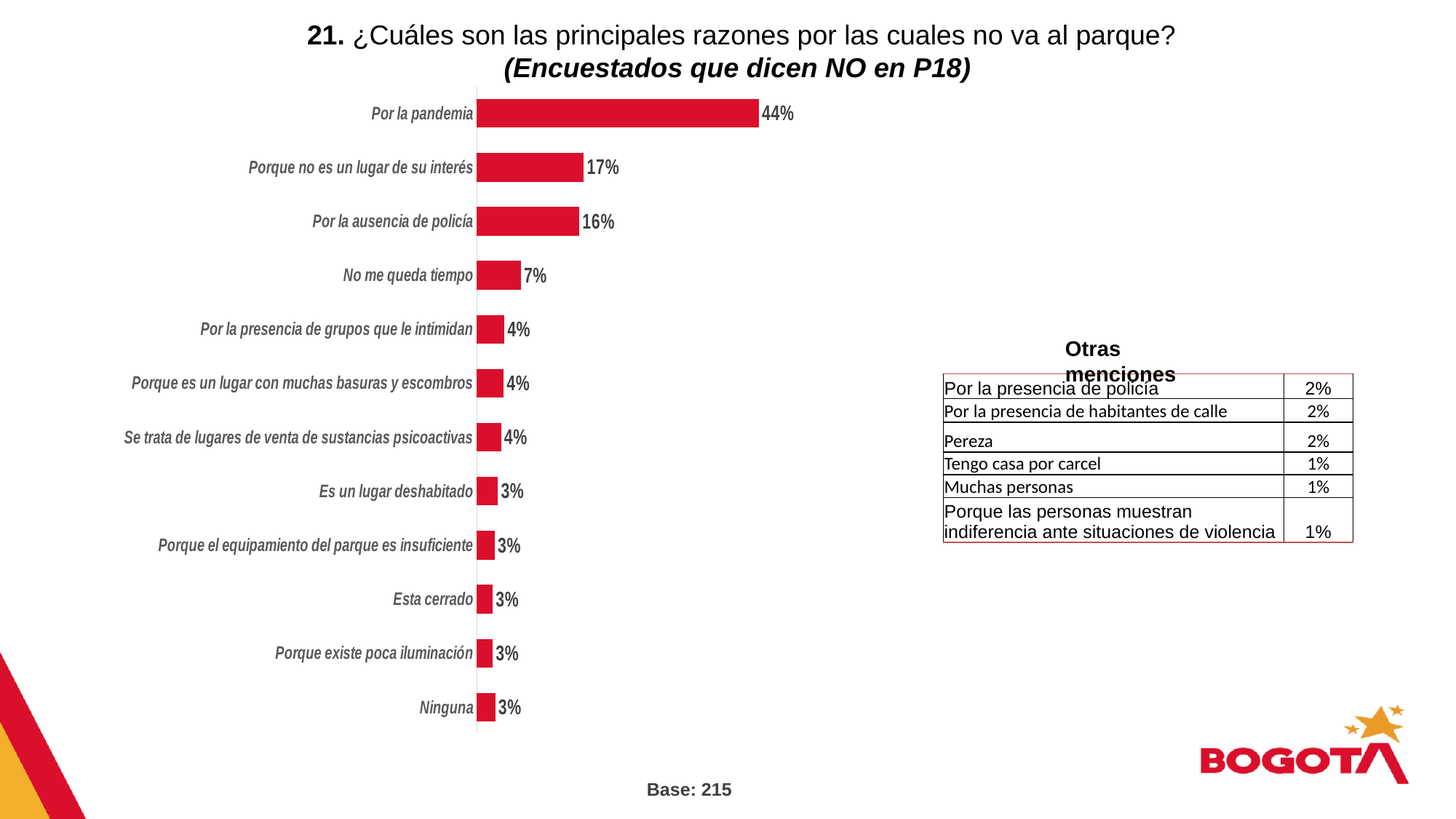
Which is larger, 'No me queda tiempo' or 'Es un lugar deshabitado'? No me queda tiempo What kind of chart is shown on the slide? Bar chart How many categories are shown in the bar chart? 12 What is the difference between 'Por la pandemia' and 'Porque no es un lugar de su interés'? 27% What is the base (number of respondents) shown on the slide? 215 What is the value for 'Por la ausencia de policía'? 16% Which is larger, 'Por la pandemia' or 'Por la ausencia de policía'? Por la pandemia What is the value for 'Porque no es un lugar de su interés'? 17% What is the value for 'Por la pandemia'? 44% What is the difference between 'Por la ausencia de policía' and 'No me queda tiempo'? 9% What is the value for 'No me queda tiempo'? 7% Which category has the highest value? Por la pandemia